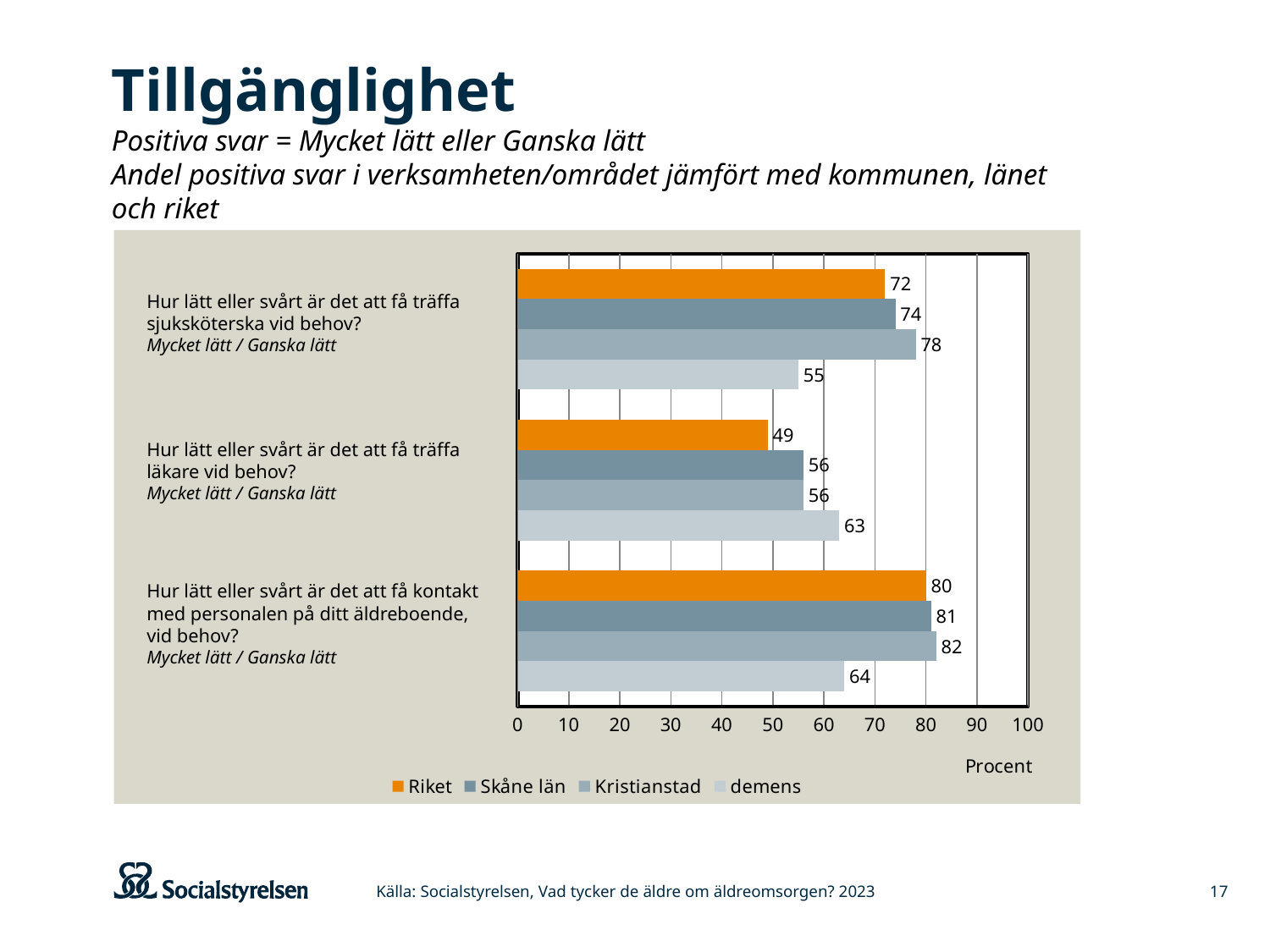
What is the value for Kristianstad on the question about getting in contact with staff at the äldreboende? 82 What kind of chart is shown on the slide? Bar chart What is the difference between Kristianstad and demens on the question about meeting a nurse (sjuksköterska) when needed? 23 What is the value for Riket on the question about meeting a nurse (sjuksköterska) when needed? 72 Which series has the highest value on the question about meeting a nurse (sjuksköterska) when needed? Kristianstad What is the value for demens on the question about meeting a doctor (läkare) when needed? 63 What is the label on the horizontal axis of the chart? Procent How many questions (categories) are shown on the chart? 3 How many series does the legend list? 4 Which series has the lowest value on the question about meeting a doctor (läkare) when needed? Riket What is the value for Skåne län on the question about meeting a doctor (läkare) when needed? 56 Which is larger on the question about contact with staff at the äldreboende: Riket or demens? Riket